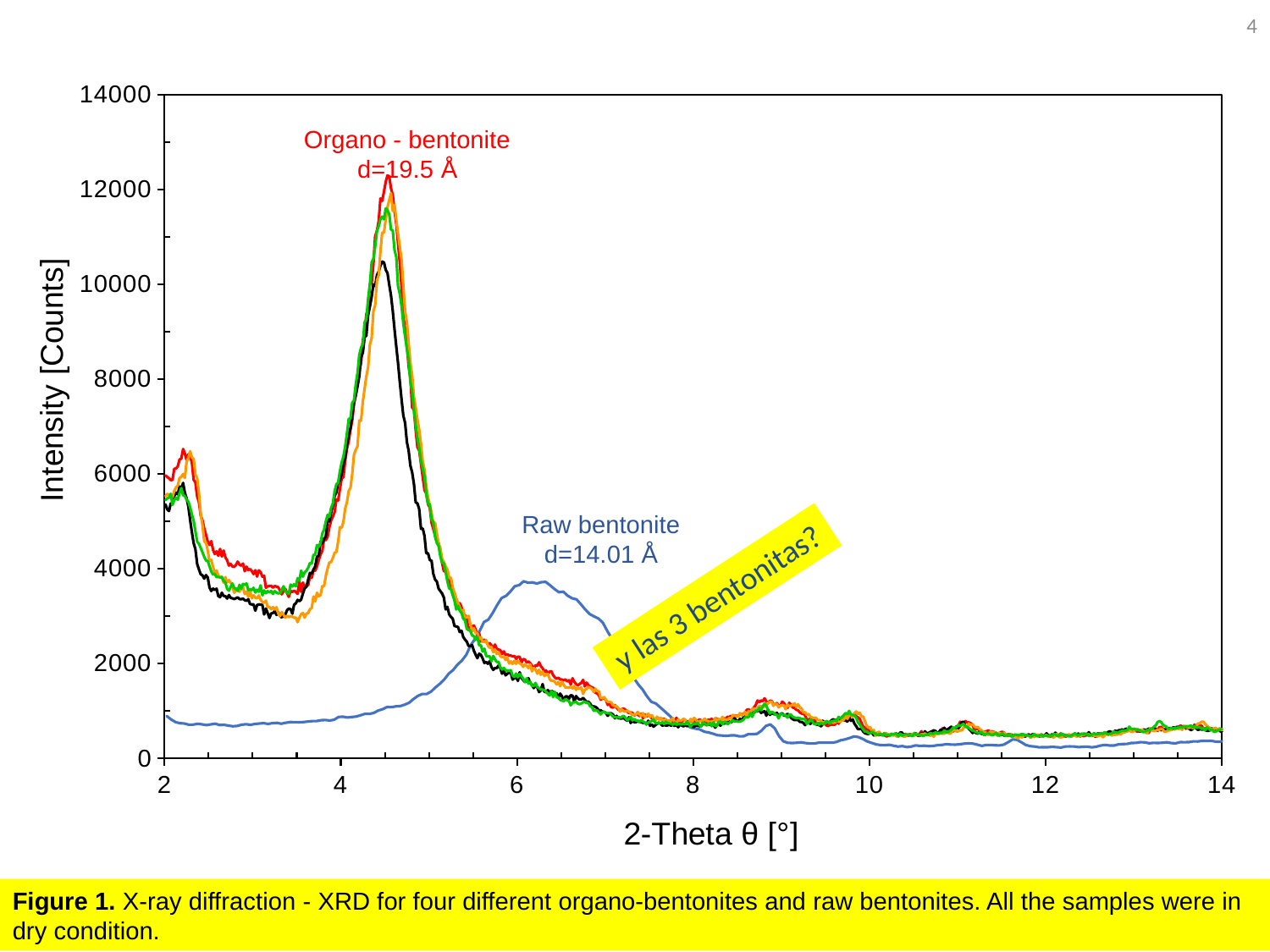
What is the label of the x axis? 2-Theta θ [°] Is the peak intensity of the raw bentonite curve greater or less than 4000 counts? less How many curves are plotted on the chart? 5 Is the highest peak intensity of the organo-bentonite curves greater or less than 10000 counts? greater What is the label of the y axis? Intensity [Counts] Which has the higher peak intensity, the organo-bentonite curves or the raw bentonite curve? organo-bentonite What kind of chart is shown on the slide? line chart What is the highest tick value shown on the y axis? 14000 Is the intensity of the raw bentonite curve at 2-Theta 2° greater or less than 2000 counts? less Does the raw bentonite curve rise or fall between 2-Theta 7° and 14°? fall What d-spacing is annotated for the organo-bentonite peak? d=19.5 Å What d-spacing is annotated for the raw bentonite peak? d=14.01 Å